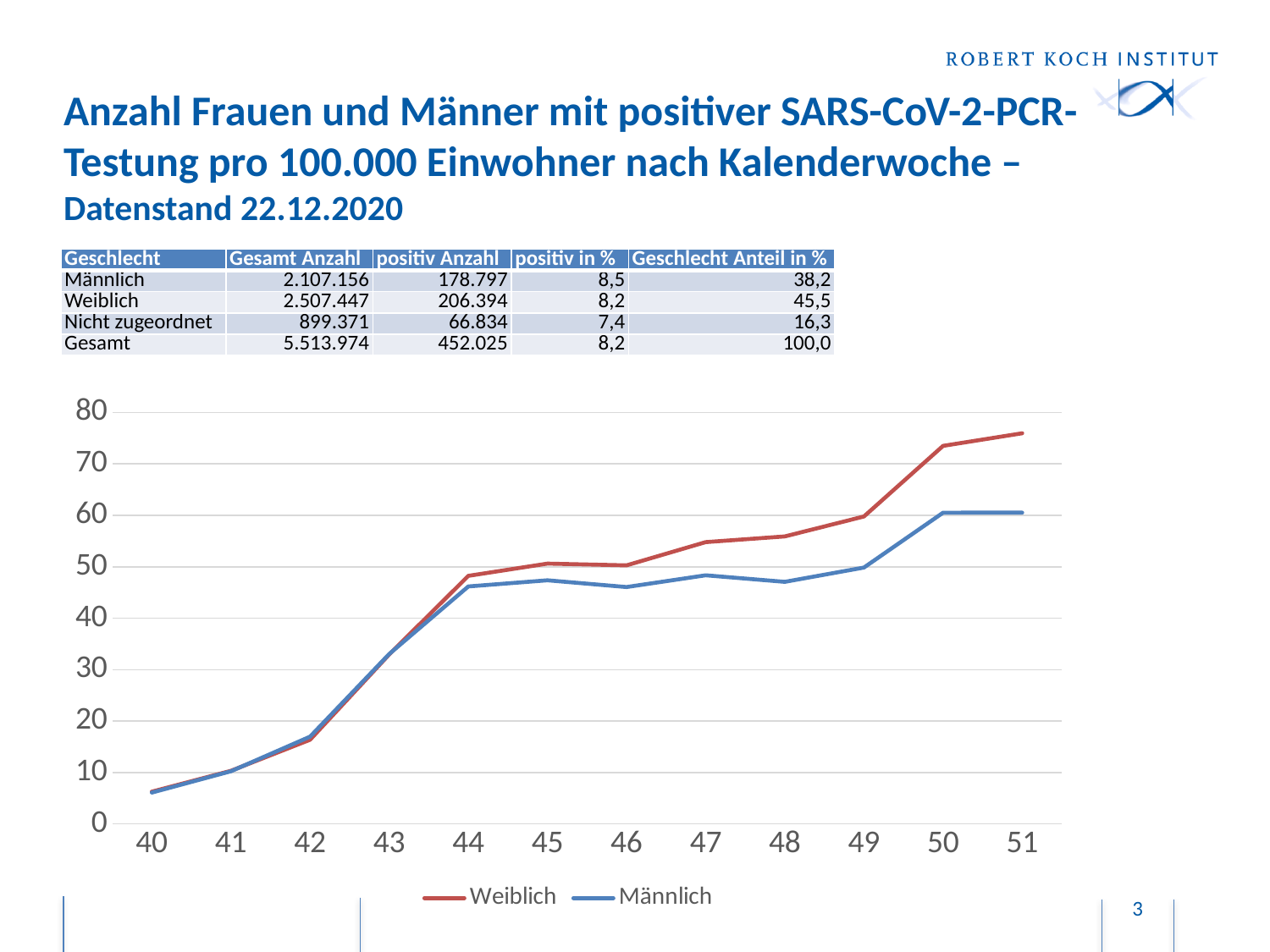
In which calendar week does the Männlich series have its lowest value? 40 In which calendar week does the Weiblich series reach its highest value? 51 Is the value for Männlich in calendar week 40 greater or less than 10? less How many calendar weeks are plotted along the x axis of the chart? 12 Is the value for Weiblich in calendar week 51 greater or less than 70? greater In calendar week 51, which series has the higher value, Weiblich or Männlich? Weiblich Do the values of the Weiblich series generally rise or fall from week 40 to week 51? rise Is the value for Männlich in calendar week 48 greater or less than 50? less How many series does the chart legend list? 2 What kind of chart is shown on the slide? line chart Which series is plotted in red in the chart? Weiblich